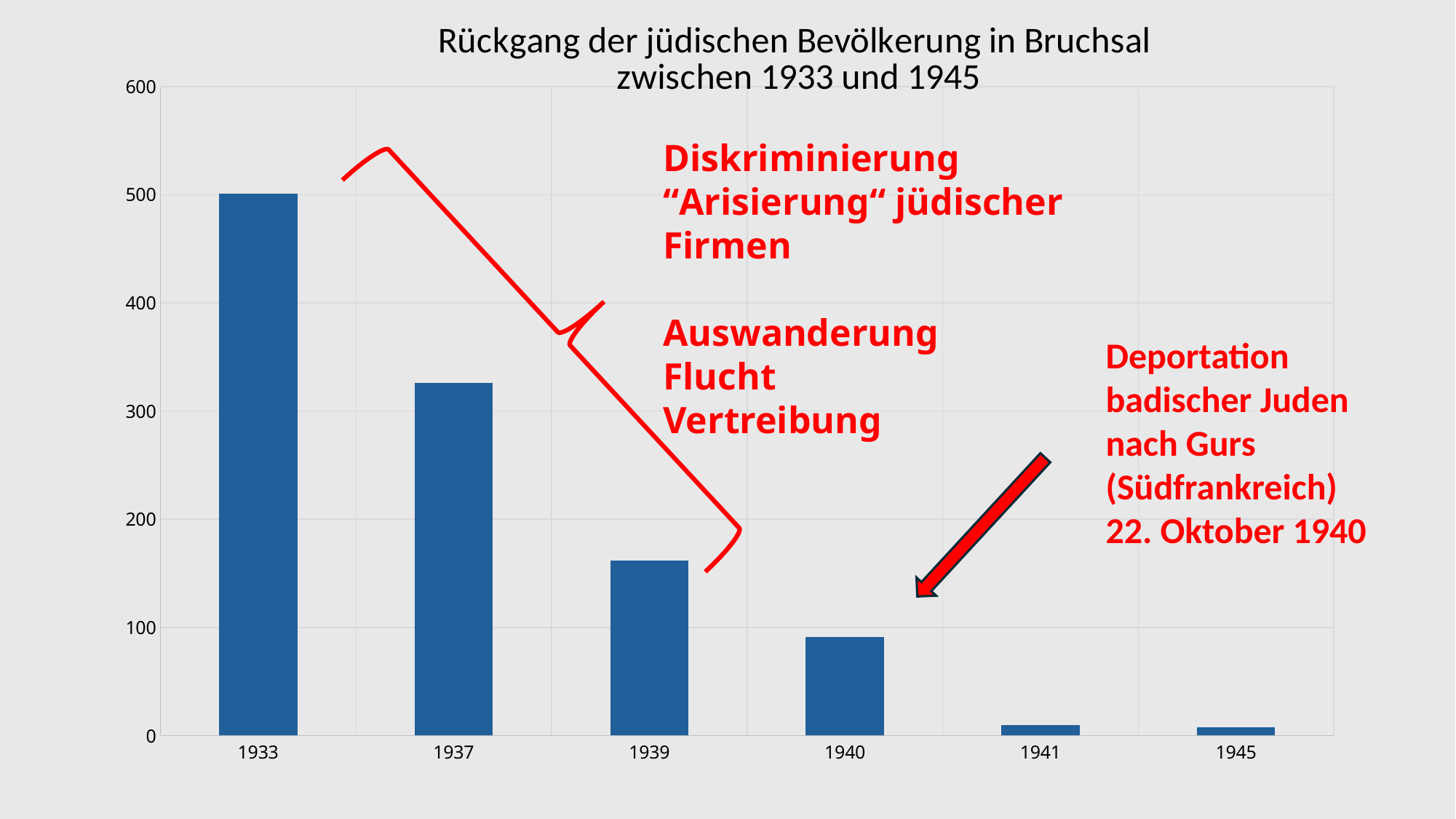
How many years are shown on the x axis of the chart? 6 Is the value for 1937 greater or less than 300? greater Which year has the highest bar in the chart? 1933 Which is larger, the value for 1937 or the value for 1939? 1937 Is the value for 1939 greater or less than 200? less What kind of chart is shown on the slide? bar chart What is the highest value shown on the y axis of the chart? 600 Is the value for 1940 greater or less than 100? less Do the values rise or fall from 1933 to 1945 along the x axis? fall What is the title of the chart? Rückgang der jüdischen Bevölkerung in Bruchsal zwischen 1933 und 1945